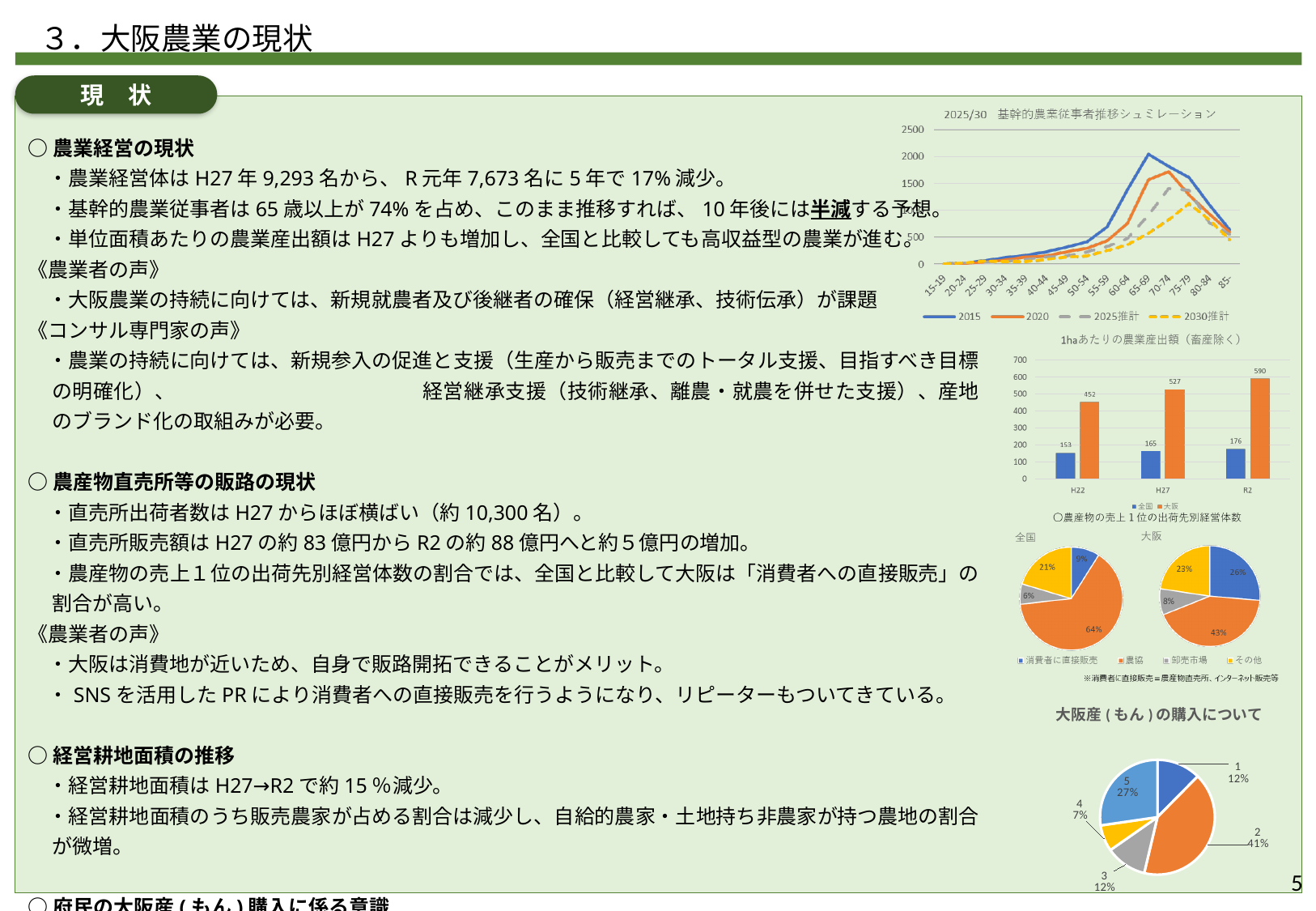
In the bar chart titled 1haあたりの農業産出額（畜産除く）, what is the value for 大阪 in R2? 590 Which is larger: the 消費者に直接販売 share in the 全国 pie chart or in the 大阪 pie chart? 大阪 In the bar chart titled 1haあたりの農業産出額（畜産除く）, how many categories are shown on the x axis? 3 How many series does the legend of the line chart titled 2025/30 基幹的農業従事者推移シュミレーション list? 4 In the 大阪 pie chart under 農産物の売上１位の出荷先別経営体数, what share is 消費者に直接販売? 26% In the bar chart titled 1haあたりの農業産出額（畜産除く）, how many series does the legend list? 2 In the pie chart titled 大阪産(もん)の購入について, which slice is the largest? 2 In the bar chart titled 1haあたりの農業産出額（畜産除く）, what is the value for 全国 in H22? 153 In the 全国 pie chart under 農産物の売上１位の出荷先別経営体数, what share is 農協? 64% In the bar chart titled 1haあたりの農業産出額（畜産除く）, do the 大阪 values rise or fall from H22 to R2? rise In the pie chart titled 大阪産(もん)の購入について, what share is slice 5? 27% In the bar chart titled 1haあたりの農業産出額（畜産除く）, what is the difference between 大阪 and 全国 in H27? 362